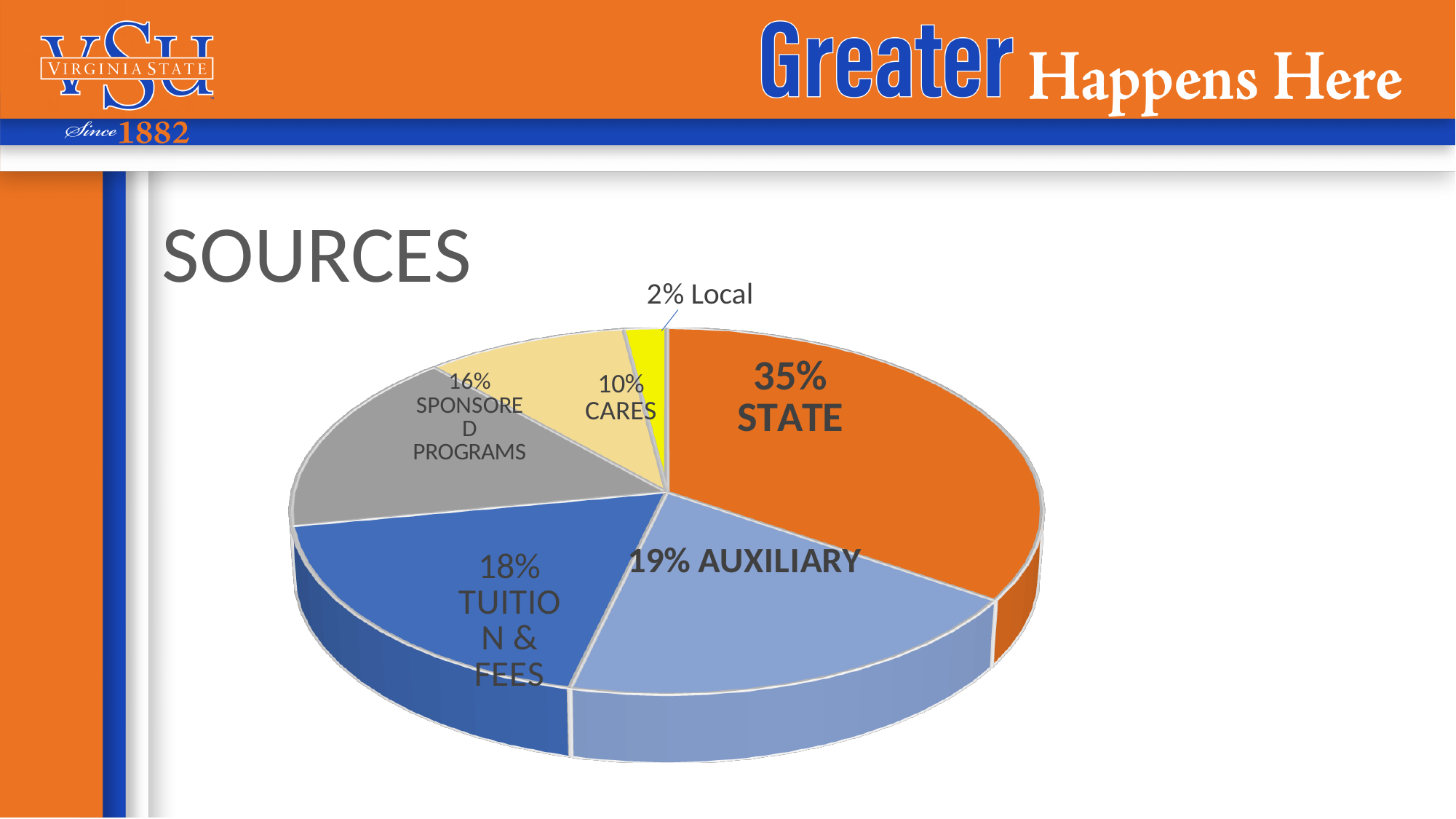
What percentage is shown for Local? 2% What percentage is shown for Sponsored Programs? 16% What share of sources does State account for? 35% Which source has the largest share? State What percentage is shown for Tuition & Fees? 18% How many slices does the pie chart have? 6 Which is larger, Sponsored Programs or CARES? Sponsored Programs What percentage is shown for CARES? 10% What percentage is shown for Auxiliary? 19% What is the difference in percentage points between State and Auxiliary? 16 Which source has the smallest share? Local What kind of chart is shown on the slide? Pie chart